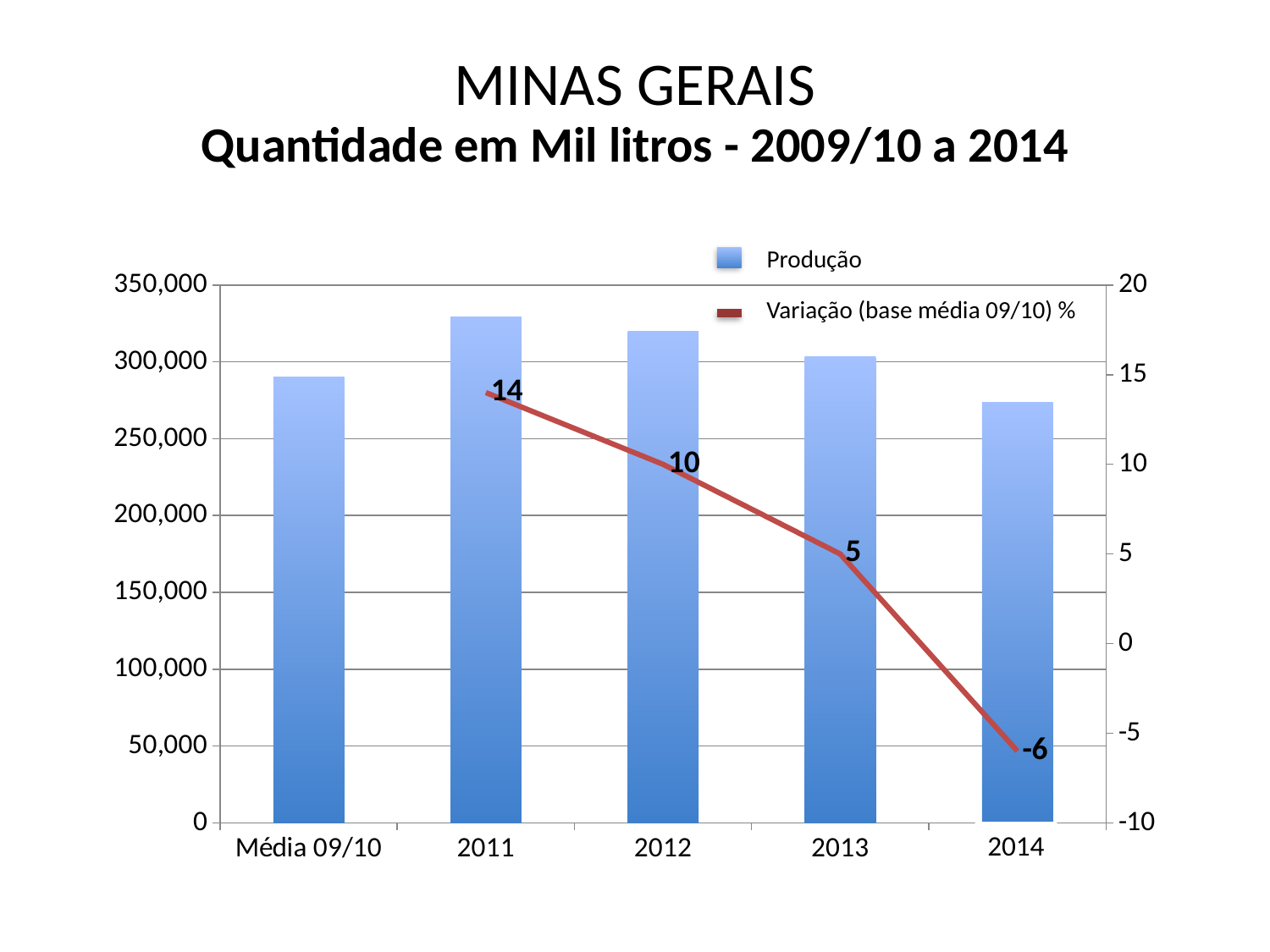
What is the value of Variação (base média 09/10) % for 2011? 14 Which year has the lowest Variação (base média 09/10) % value? 2014 How many series does the legend list? 2 Which year has the highest Variação (base média 09/10) % value? 2011 Does the Variação (base média 09/10) % line rise or fall from 2011 to 2014? fall Is the Produção value for 2014 greater or less than 300,000? less What is the difference between the Variação values for 2011 and 2012? 4 How many categories are shown on the x axis? 5 Which has the lower Produção bar, Média 09/10 or 2014? 2014 Is the Produção value for 2011 greater or less than 300,000? greater What is the value of Variação (base média 09/10) % for 2014? -6 What is the value of Variação (base média 09/10) % for 2013? 5